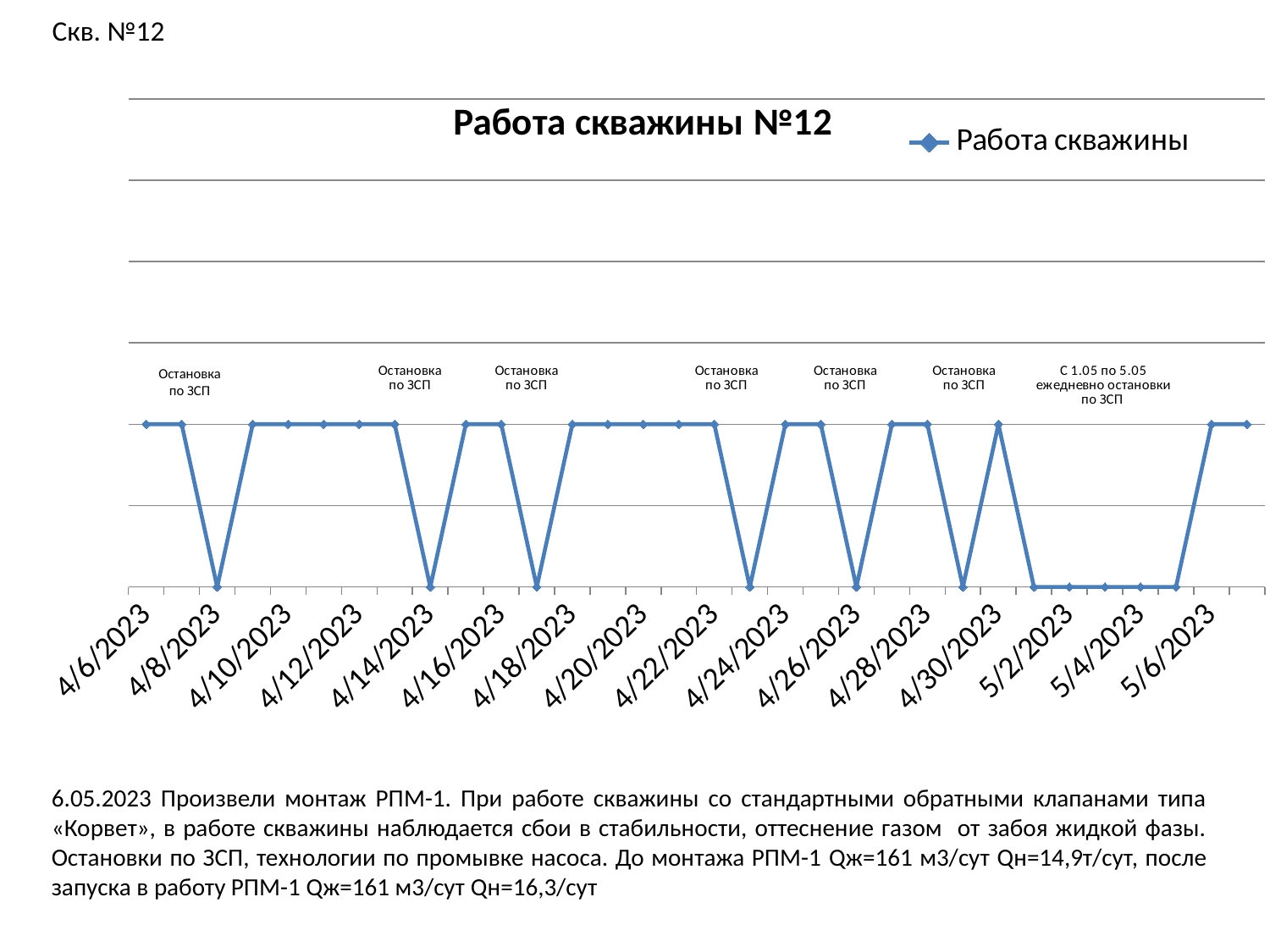
What is the last date label on the x axis? 5/6/2023 Which is higher, the value on 5/2/2023 or the value on 5/6/2023? 5/6/2023 Which is lower, the value on 4/24/2023 or the value on 4/26/2023? 4/26/2023 Which is higher, the value on 4/6/2023 or the value on 4/8/2023? 4/6/2023 What is the first date label on the x axis? 4/6/2023 What type of chart is shown on the slide? Line chart What series name is listed in the chart legend? Работа скважины How many date labels are shown along the x axis? 16 What is the title of the chart? Работа скважины №12 How many series does the legend list? 1